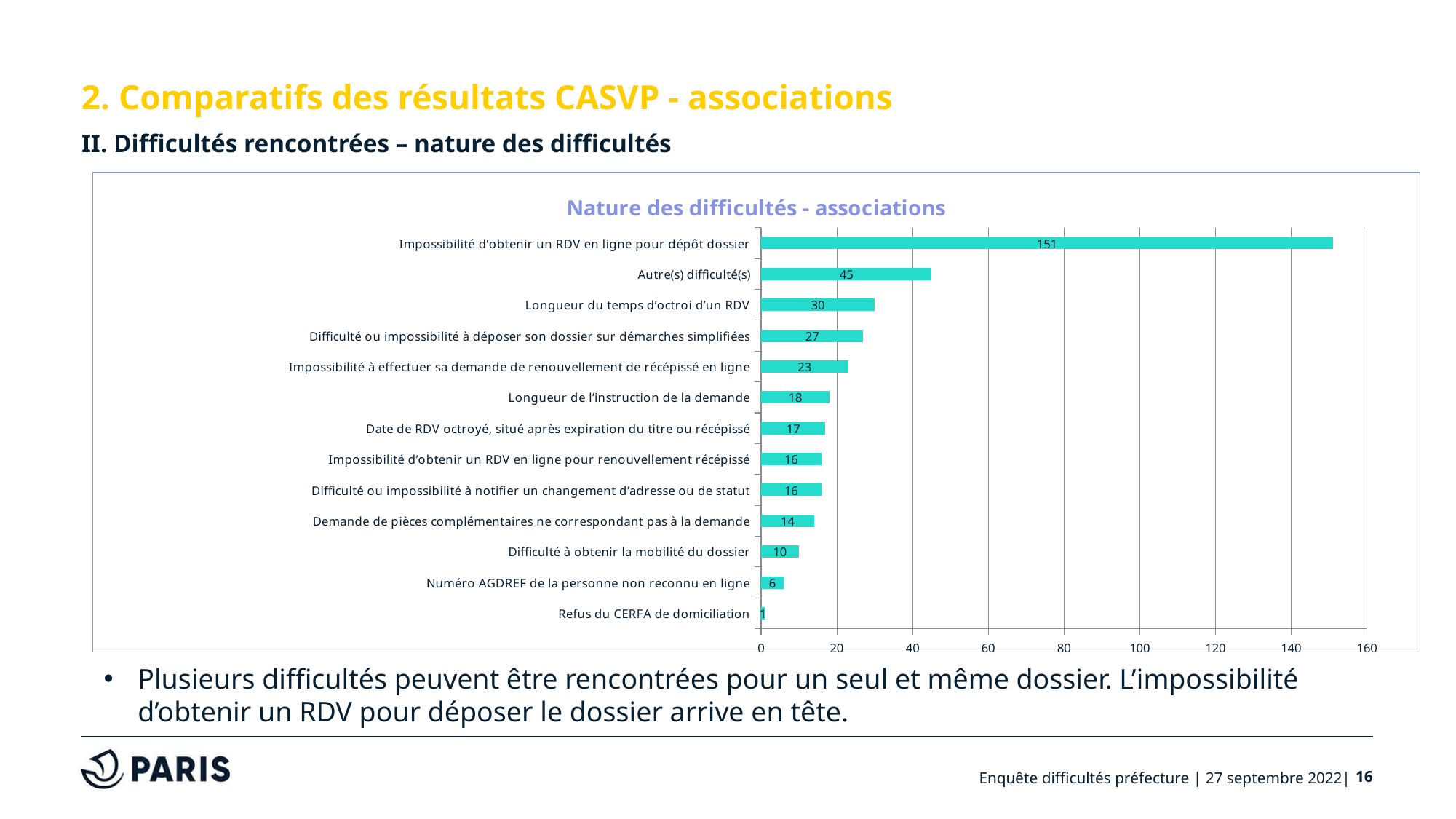
What is the value for "Autre(s) difficulté(s)"? 45 What is the difference between the values for "Autre(s) difficulté(s)" and "Longueur du temps d'octroi d'un RDV"? 15 Is the value for "Impossibilité d'obtenir un RDV en ligne pour dépôt dossier" greater or less than 140? greater Which is larger: the value for "Longueur de l'instruction de la demande" or the value for "Demande de pièces complémentaires ne correspondant pas à la demande"? Longueur de l'instruction de la demande Which category has the highest value? Impossibilité d'obtenir un RDV en ligne pour dépôt dossier What is the value for "Impossibilité d'obtenir un RDV en ligne pour dépôt dossier"? 151 How many categories are shown in the chart? 13 What is the value for "Longueur du temps d'octroi d'un RDV"? 30 What is the value for "Numéro AGDREF de la personne non reconnu en ligne"? 6 What is the title of the chart? Nature des difficultés - associations Which category has the lowest value? Refus du CERFA de domiciliation What kind of chart is shown on the slide? Bar chart